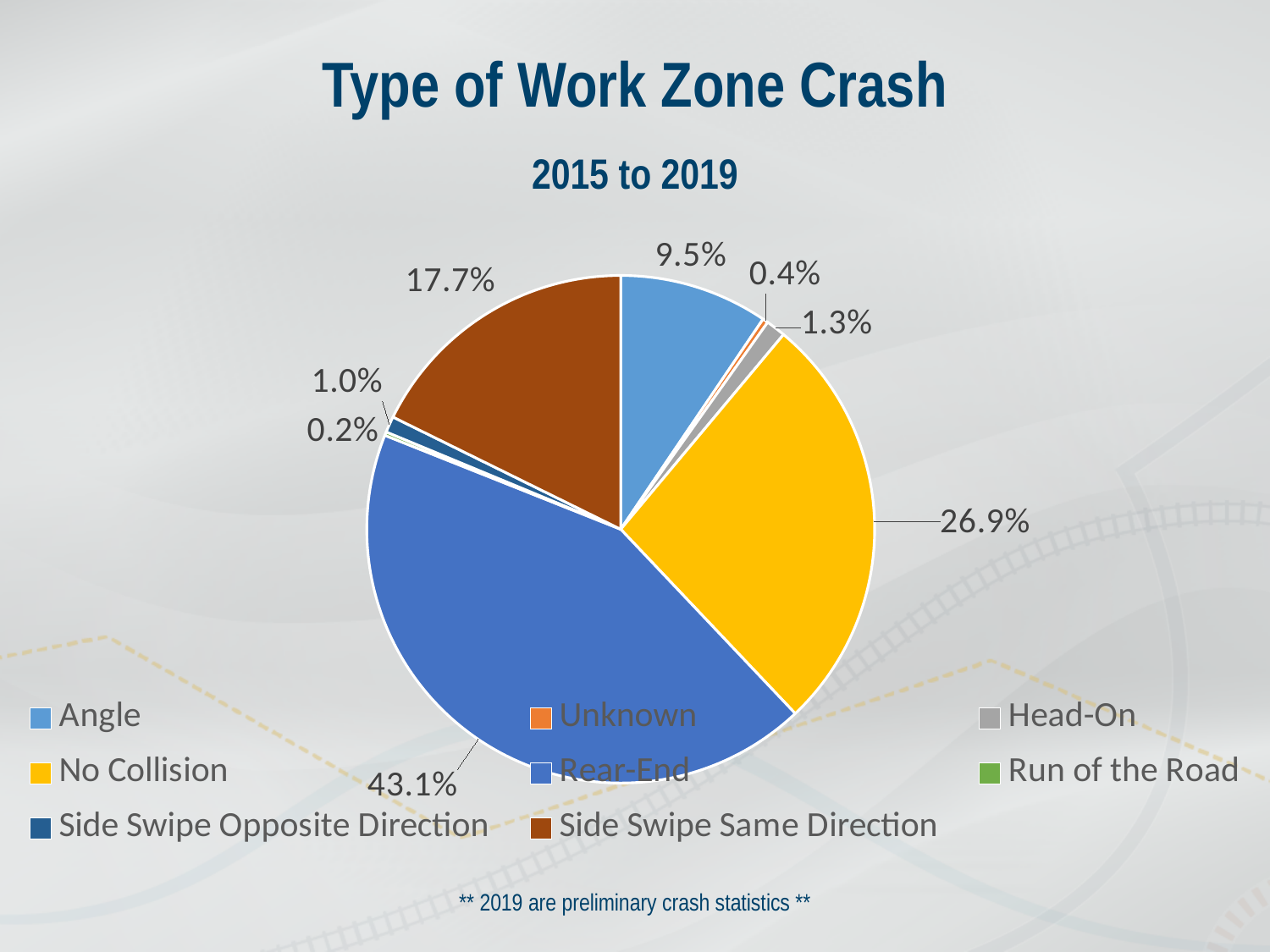
Which is larger, the share of Angle crashes or the share of Side Swipe Same Direction crashes? Side Swipe Same Direction What percentage of work zone crashes are Head-On? 1.3% What is the difference in percentage points between Rear-End and No Collision crashes? 16.2 What percentage of work zone crashes are Side Swipe Same Direction? 17.7% What percentage of work zone crashes are No Collision? 26.9% What type of chart is shown on the slide? Pie chart How many crash types does the legend list? 8 What percentage of work zone crashes are Unknown? 0.4% What years does the chart cover, according to the subtitle? 2015 to 2019 What percentage of work zone crashes are Angle crashes? 9.5% Which crash type has the largest share of work zone crashes? Rear-End What percentage of work zone crashes are Rear-End? 43.1%